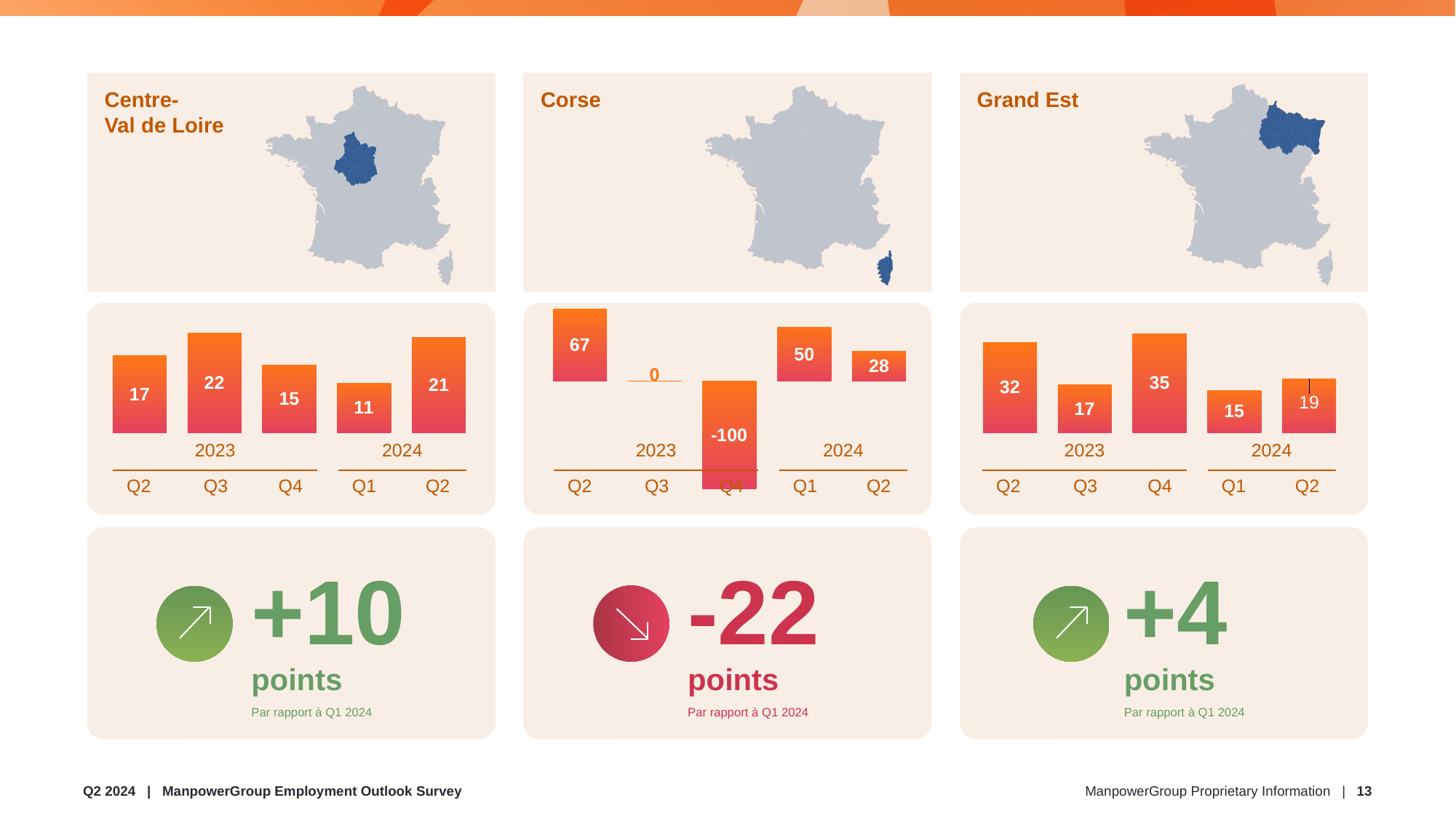
In the Centre-Val de Loire chart, what is the value for Q3 2023? 22 In the Corse chart, is the value for Q1 2024 larger or smaller than the value for Q2 2024? larger How many quarters are plotted in the Grand Est chart? 5 In the Grand Est chart, which quarter has the lowest value? Q1 2024 In the Grand Est chart, what is the value for Q4 2023? 35 In the Corse chart, what is the value for Q3 2023? 0 In the Centre-Val de Loire chart, what is the difference between Q2 2024 and Q1 2024? 10 In the Corse chart, what is the value for Q4 2023? -100 In the Centre-Val de Loire chart, which quarter has the lowest value? Q1 2024 In the Corse chart, which quarter has the highest value? Q2 2023 What type of chart is used for the Corse panel? Bar chart In the Grand Est chart, what is the difference between Q2 2023 and Q3 2023? 15